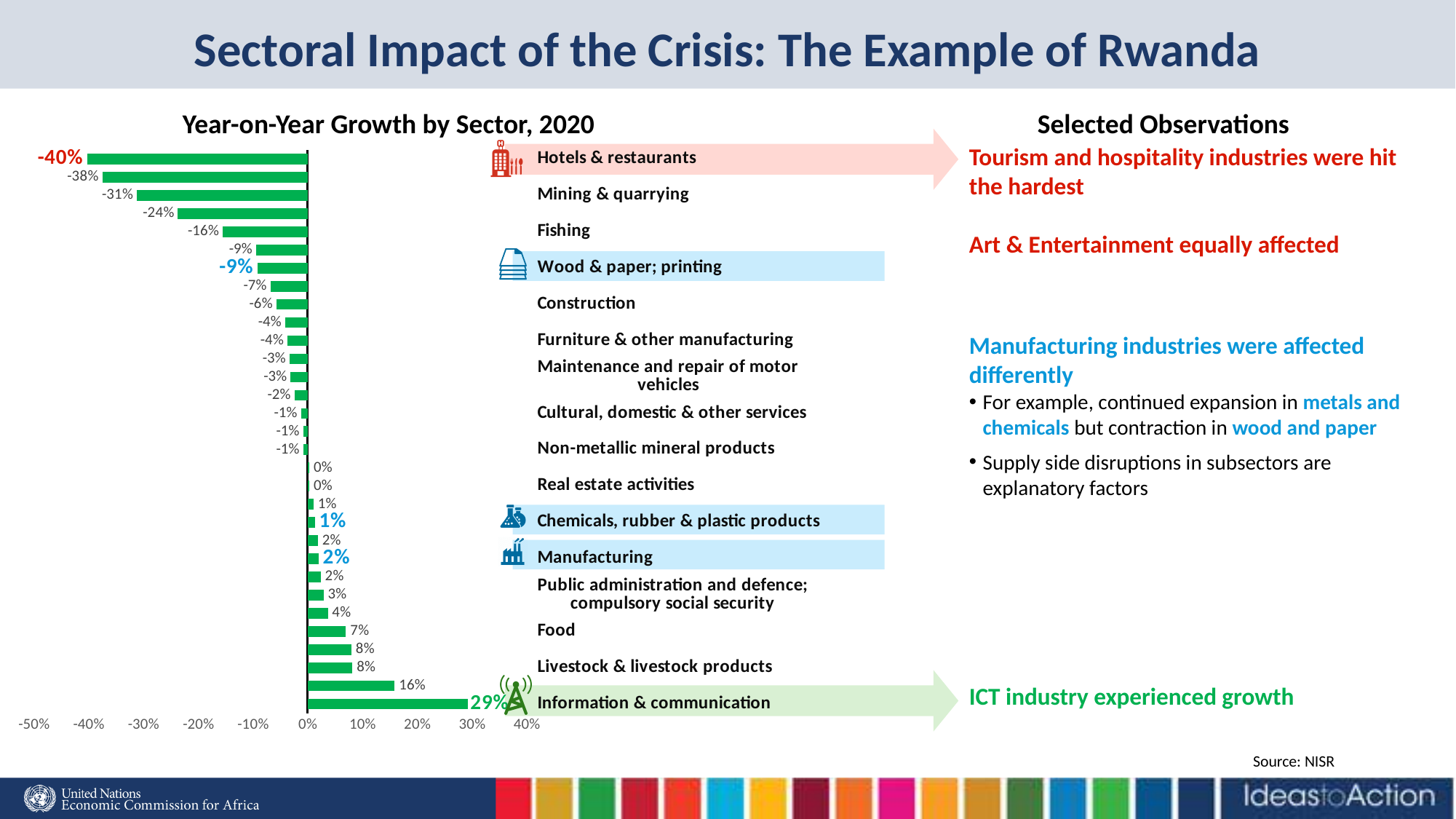
What is the year-on-year growth value shown for Hotels & restaurants? -40% What is the year-on-year growth value shown for Manufacturing? 2% Which sector has the lowest year-on-year growth in the chart? Hotels & restaurants What is the title of the chart on the slide? Year-on-Year Growth by Sector, 2020 What is the year-on-year growth value shown for Chemicals, rubber & plastic products? 1% What is the difference in percentage points between the growth of Information & communication and Hotels & restaurants? 69 percentage points Which sector has the highest year-on-year growth in the chart? Information & communication Which has the higher growth value, Manufacturing or Chemicals, rubber & plastic products? Manufacturing What is the year-on-year growth value shown for Wood & paper; printing? -9% What is the year-on-year growth value shown for Information & communication? 29% What type of chart is used to show year-on-year growth by sector? Bar chart What is the difference in percentage points between the growth of Manufacturing and Wood & paper; printing? 11 percentage points